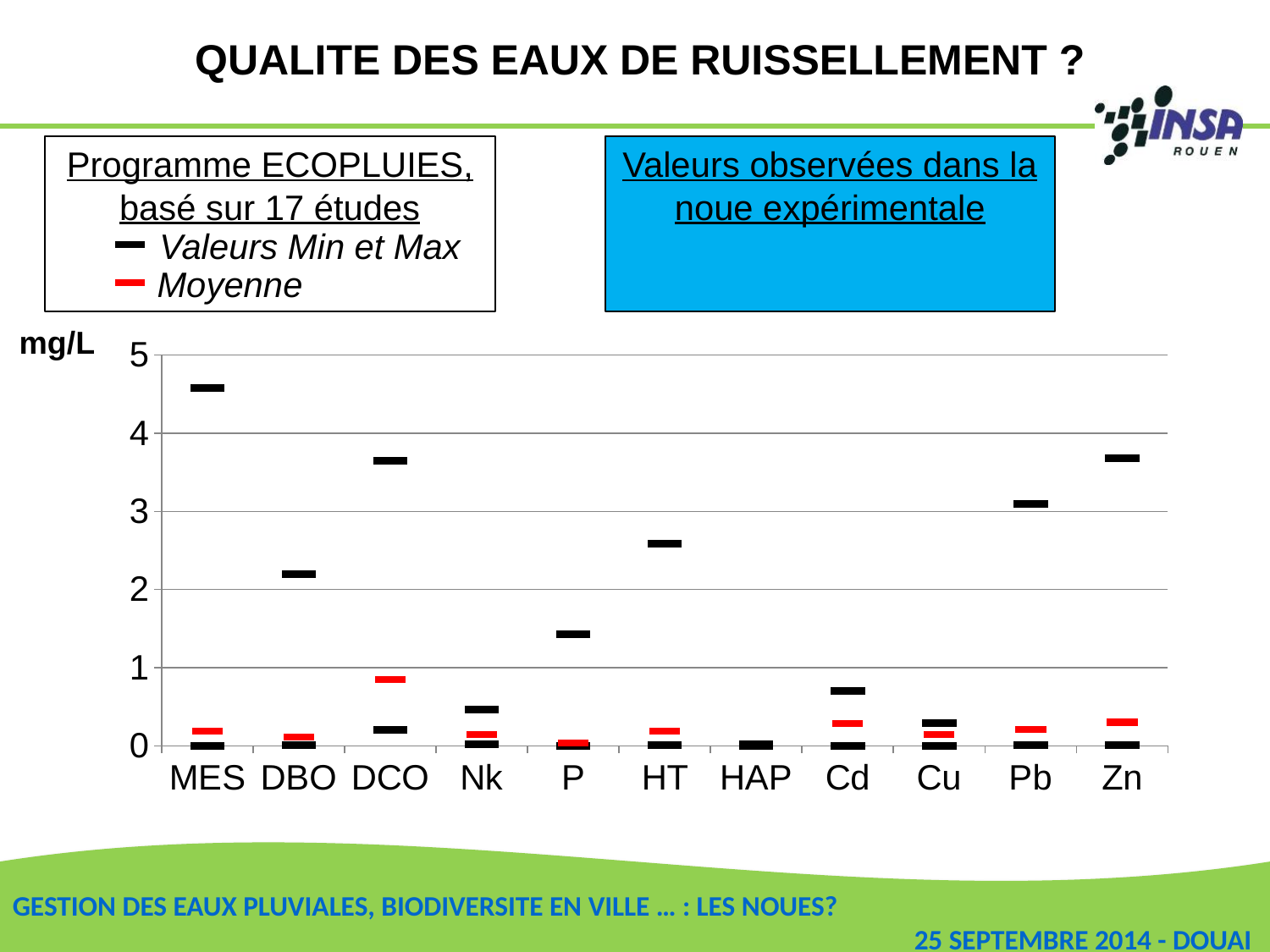
Is the maximum value for HT greater or less than 2? greater Which category has the highest maximum (black marker) value on the chart? MES How many categories (parameters) are shown along the x axis of the chart? 11 Is the maximum value for MES greater or less than 4? greater Is the maximum value for Cd greater or less than 1? less Which is larger, the maximum value for MES or the maximum value for Zn? MES According to the legend, what do the red markers on the chart represent? Moyenne What unit is shown on the y axis of the chart? mg/L Which category has the highest mean (red marker) value on the chart? DCO